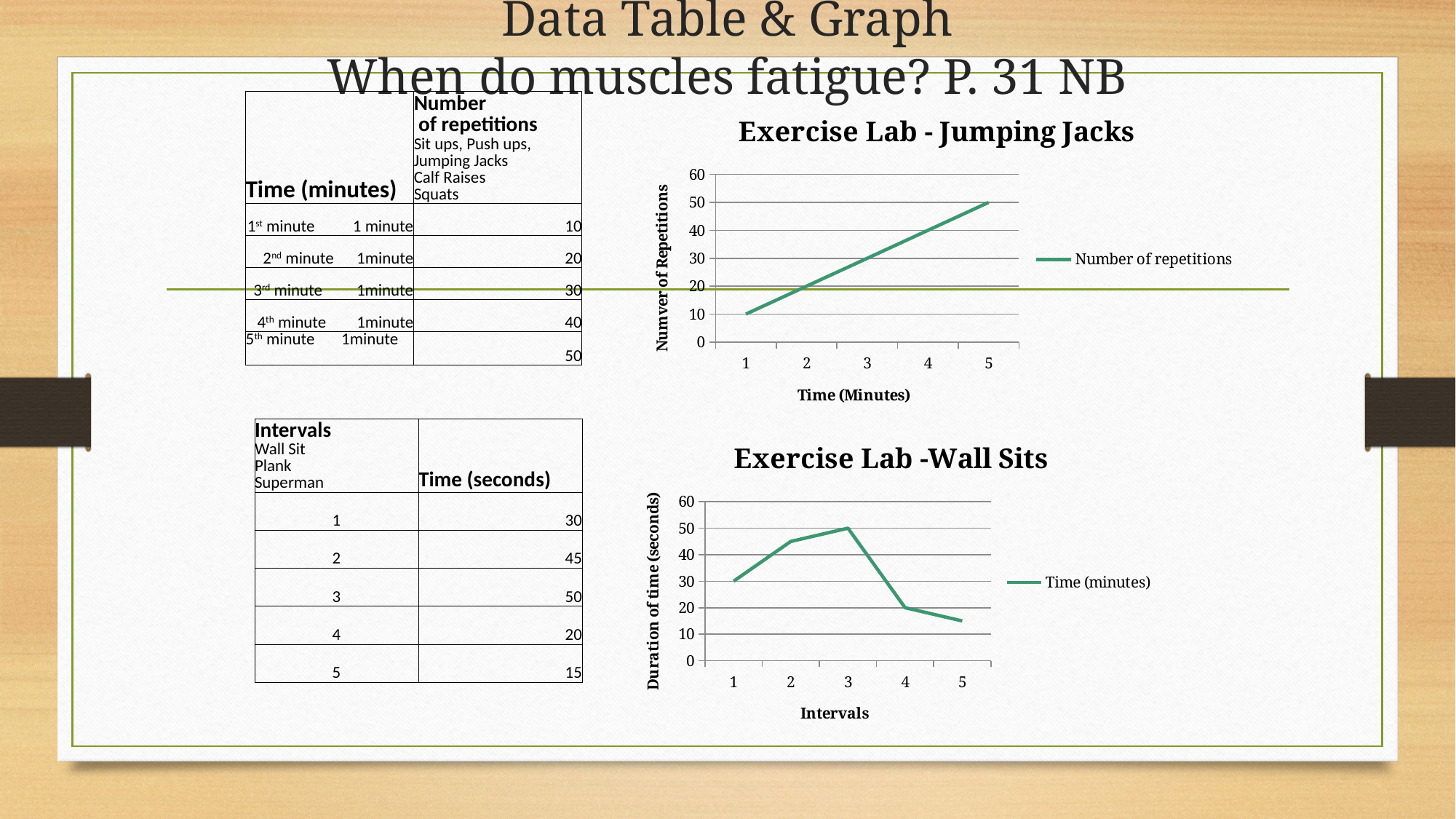
In the 'Exercise Lab -Wall Sits' chart, which interval has the lowest duration? 5 In the 'Exercise Lab - Jumping Jacks' chart, what is the difference in repetitions between minute 5 and minute 1? 40 How many time points are plotted in the 'Exercise Lab - Jumping Jacks' chart? 5 In the 'Exercise Lab -Wall Sits' chart, which interval has the highest duration? 3 What is the series name shown in the legend of the 'Exercise Lab - Jumping Jacks' chart? Number of repetitions In the 'Exercise Lab - Jumping Jacks' chart, what is the number of repetitions at minute 5? 50 In the 'Exercise Lab -Wall Sits' chart, which is larger: the duration at interval 1 or at interval 4? interval 1 What type of chart is the 'Exercise Lab - Jumping Jacks' chart? line chart In the 'Exercise Lab - Jumping Jacks' chart, do the values rise or fall as time increases? rise In the 'Exercise Lab -Wall Sits' chart, is the duration at interval 2 greater or less than 40? greater In the 'Exercise Lab -Wall Sits' chart, what is the duration at interval 3? 50 In the 'Exercise Lab - Jumping Jacks' chart, what is the number of repetitions at minute 3? 30